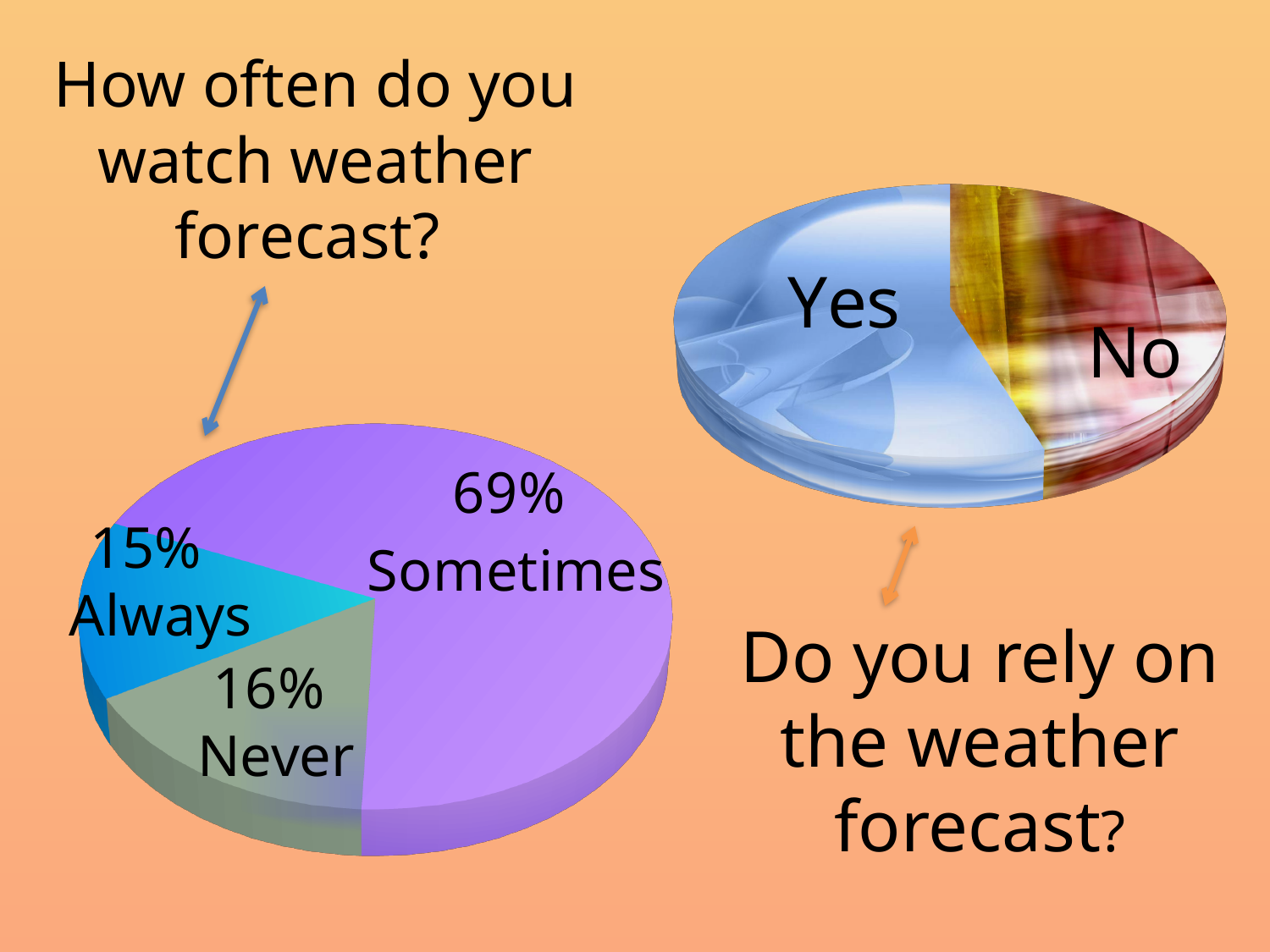
In the pie chart titled "How often do you watch weather forecast?", which response has the smallest share? Always In the pie chart titled "Do you rely on the weather forecast?", which slice is larger, Yes or No? Yes In the pie chart titled "How often do you watch weather forecast?", what is the difference between the Never and Always shares? 1% In the pie chart titled "How often do you watch weather forecast?", what percentage of respondents answered Sometimes? 69% What type of chart is used for "Do you rely on the weather forecast?"? Pie chart In the pie chart titled "How often do you watch weather forecast?", what percentage of respondents answered Always? 15% In the pie chart titled "How often do you watch weather forecast?", which response has the largest share? Sometimes In the pie chart titled "How often do you watch weather forecast?", which is larger, the share for Sometimes or the share for Never? Sometimes In the pie chart titled "Do you rely on the weather forecast?", how many slices does the pie have? 2 In the pie chart titled "How often do you watch weather forecast?", what percentage of respondents answered Never? 16% In the pie chart titled "How often do you watch weather forecast?", how many slices does the pie have? 3 In the pie chart titled "How often do you watch weather forecast?", how many percentage points larger is Sometimes than Never? 53%